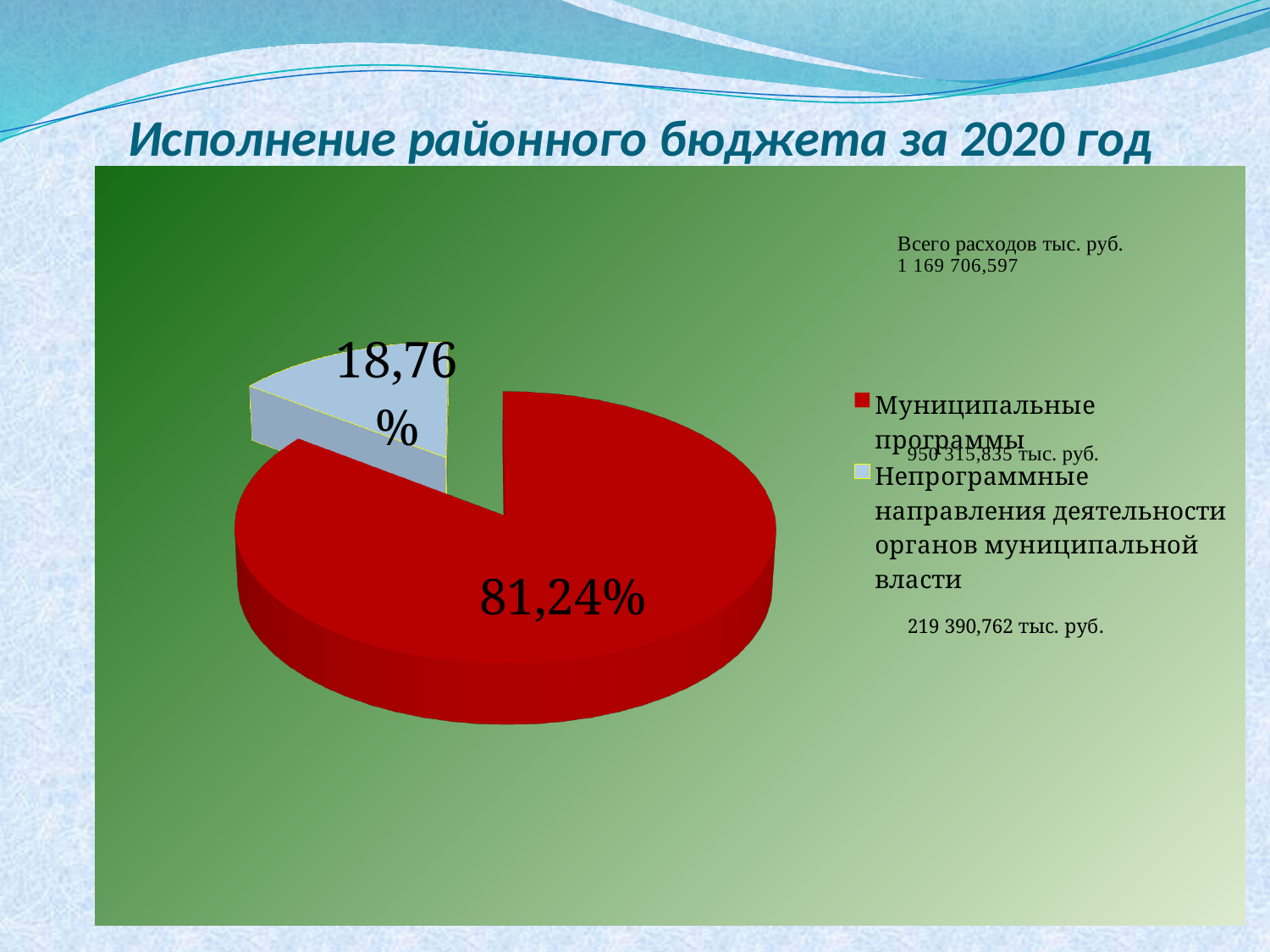
What share of the pie is labelled for Муниципальные программы? 81,24% What kind of chart is shown on the slide? Pie chart Which category has the smallest slice of the pie? Непрограммные направления деятельности органов муниципальной власти How many entries does the legend list? 2 What is the title of the slide containing the pie chart? Исполнение районного бюджета за 2020 год Is the share for Муниципальные программы greater or less than 50%? greater What is the difference in percentage points between the two slices of the pie? 62,48% How many slices does the pie chart have? 2 What share of the pie is labelled for Непрограммные направления деятельности органов муниципальной власти? 18,76% Which is larger: the slice for Муниципальные программы or the slice for Непрограммные направления деятельности органов муниципальной власти? Муниципальные программы Which category has the largest slice of the pie? Муниципальные программы What colour is the slice for Муниципальные программы? Red